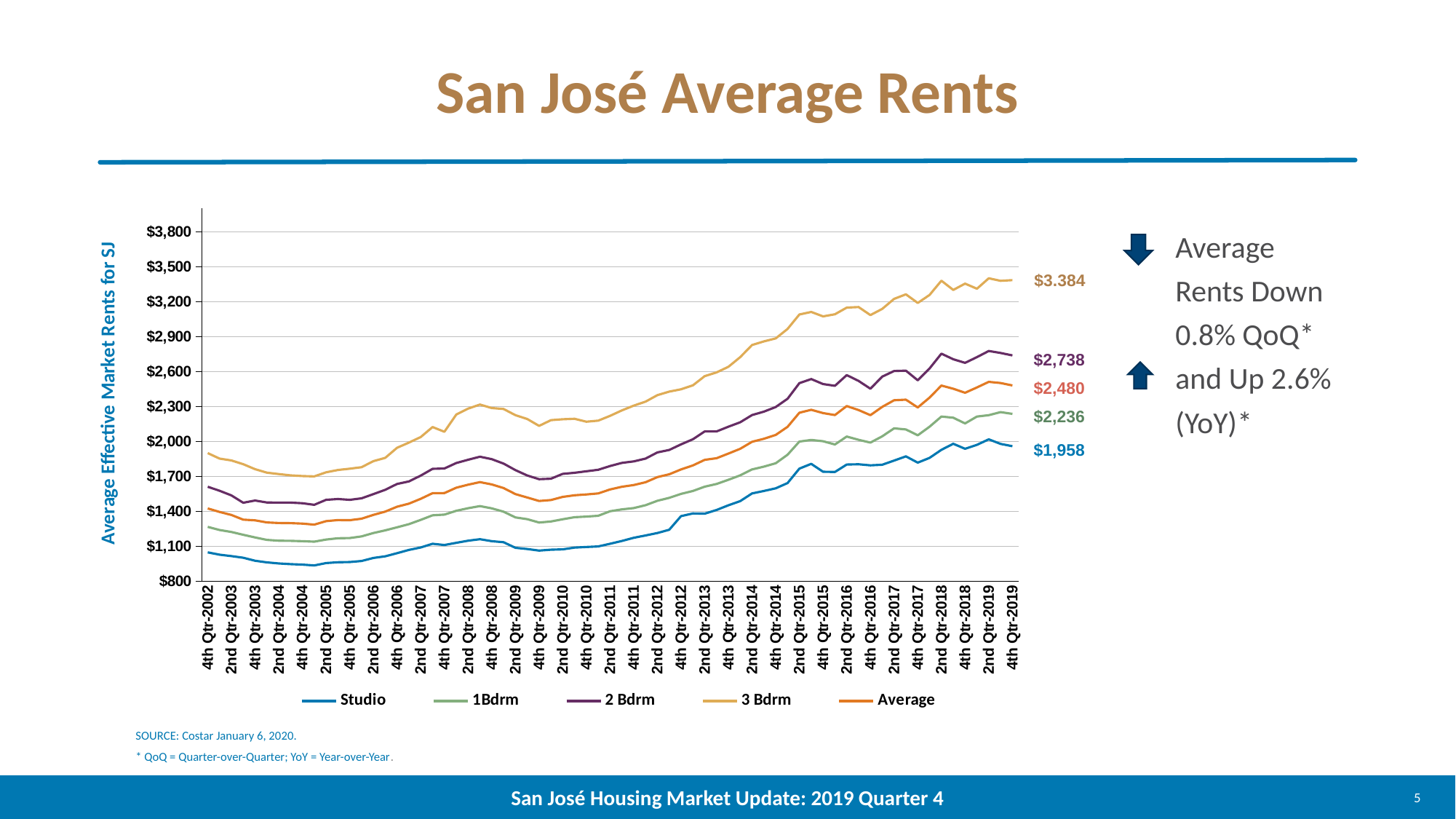
What is the value labelled at the end of the Studio line? $1,958 Which series has the highest value at 4th Qtr 2019? 3 Bdrm What is the label on the vertical axis of the chart? Average Effective Market Rents for SJ Does the Studio line generally rise or fall from 4th Qtr 2002 to 4th Qtr 2019? rise What is the value labelled at the end of the 2 Bdrm line? $2,738 How many series does the legend list? 5 What is the value labelled at the end of the Average line? $2,480 What is the value labelled at the end of the 1Bdrm line? $2,236 Is the Studio value at 4th Qtr 2002 greater or less than $1,100? less What is the difference between the 2 Bdrm and Studio values labelled at the end of the lines? $780 What type of chart is shown on the slide? line chart Which series has the lowest value at 4th Qtr 2019? Studio